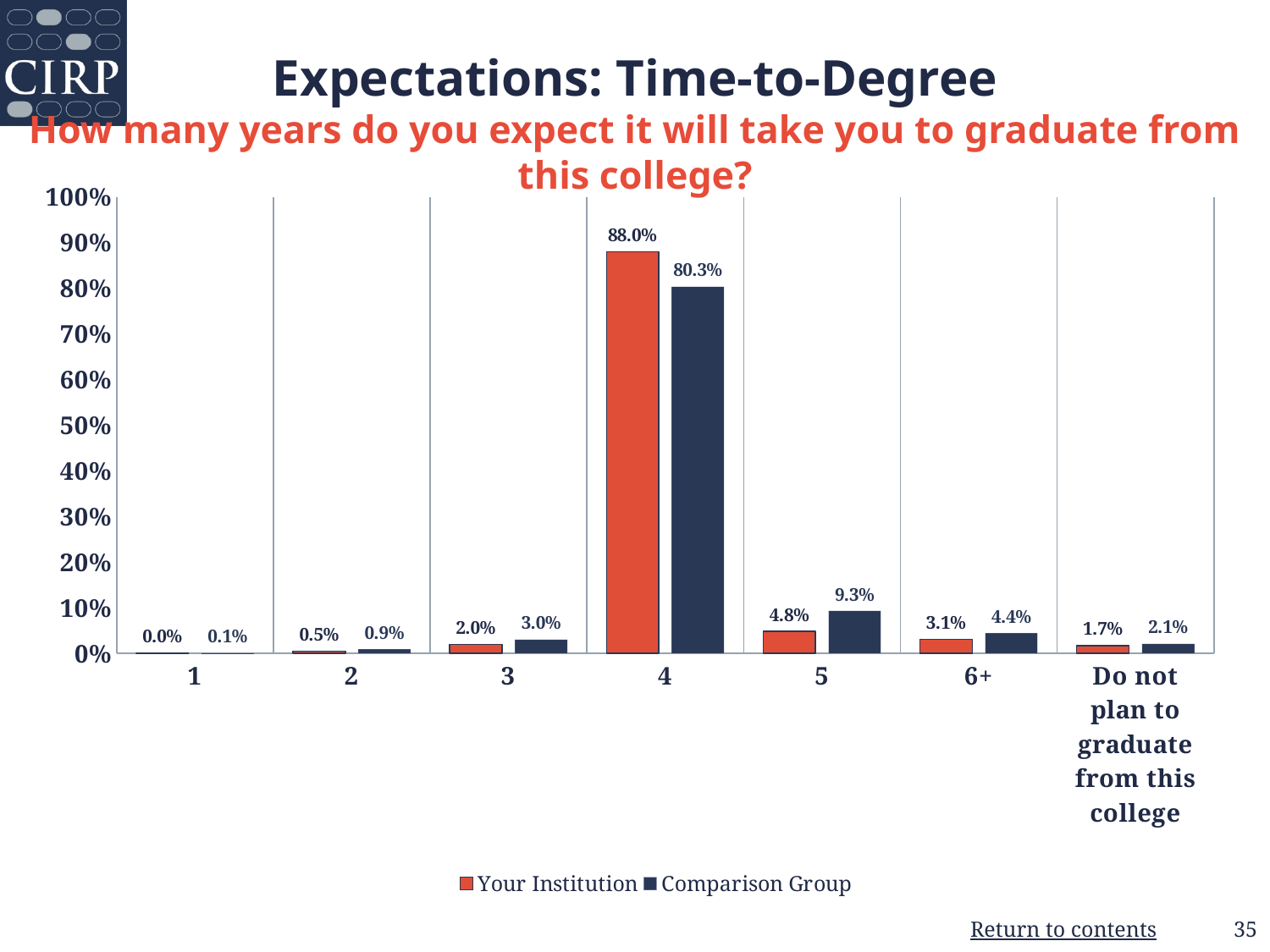
Which is larger for the category 5: Your Institution or Comparison Group? Comparison Group How many categories are shown on the x axis? 7 What is the value for Your Institution for the category 4? 88.0% Which series is shown in dark navy in the legend? Comparison Group What is the value for Comparison Group for the category 6+? 4.4% What is the value for Your Institution for the category 'Do not plan to graduate from this college'? 1.7% How many series does the legend list? 2 What kind of chart is shown on the slide? Bar chart Which category has the highest value for Your Institution? 4 What is the difference between Your Institution and Comparison Group for the category 4? 7.7% Which category has the lowest value for Comparison Group? 1 What is the value for Comparison Group for the category 5? 9.3%